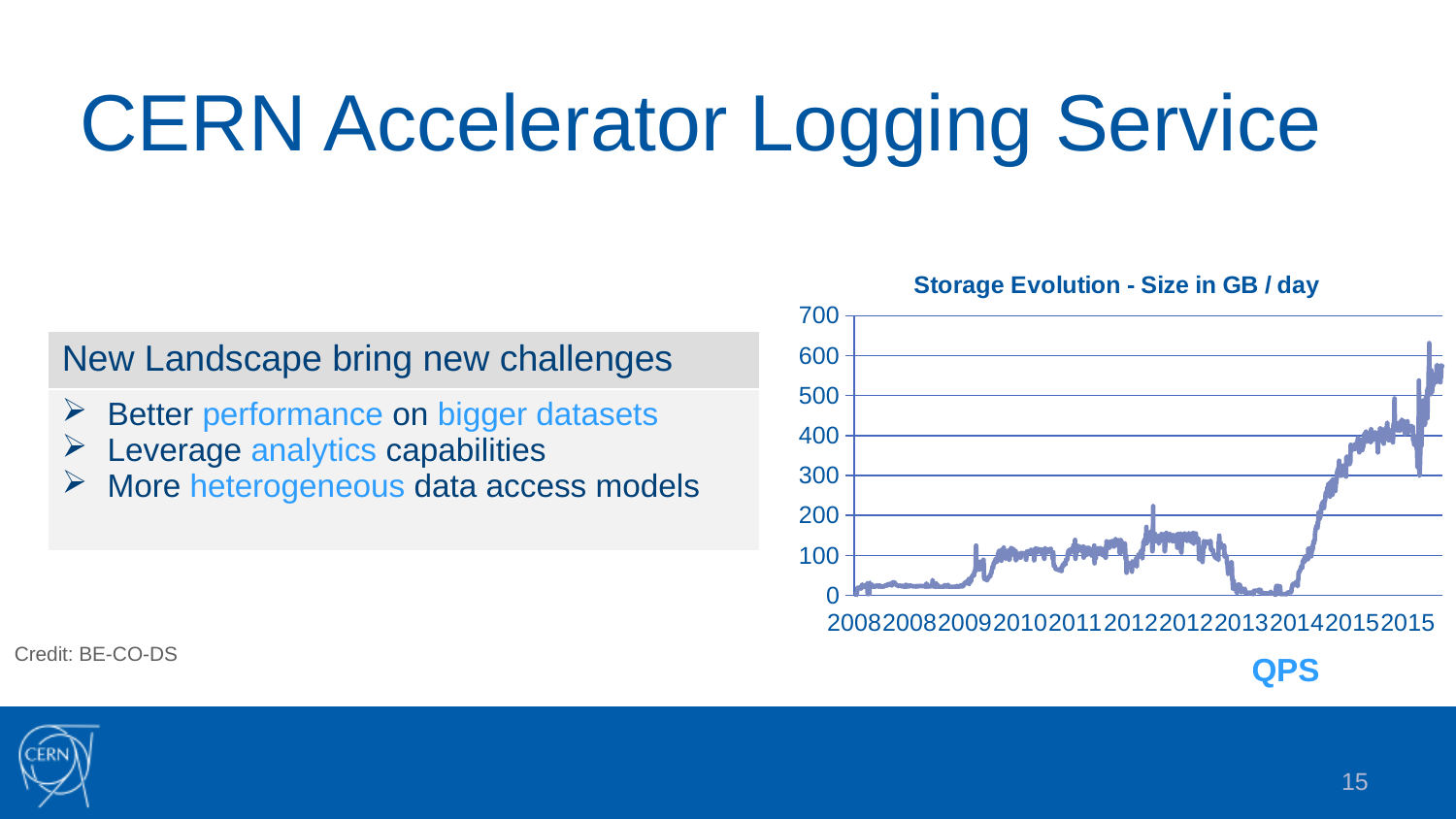
In the Storage Evolution chart, is the highest value reached greater or less than 500? greater Overall, do the values in the Storage Evolution chart rise or fall from 2008 to 2015? rise In the Storage Evolution chart, is the value at the end of 2015 greater or less than 400? greater What kind of chart is shown on the slide? line chart In the Storage Evolution chart, is the value in 2013 greater or less than 100? less What is the title of the chart on the slide? Storage Evolution - Size in GB / day What is the highest value shown on the y axis of the Storage Evolution chart? 700 How many year labels are shown along the x axis of the Storage Evolution chart? 11 In the Storage Evolution chart, is the value in 2015 larger or smaller than the value in 2009? larger